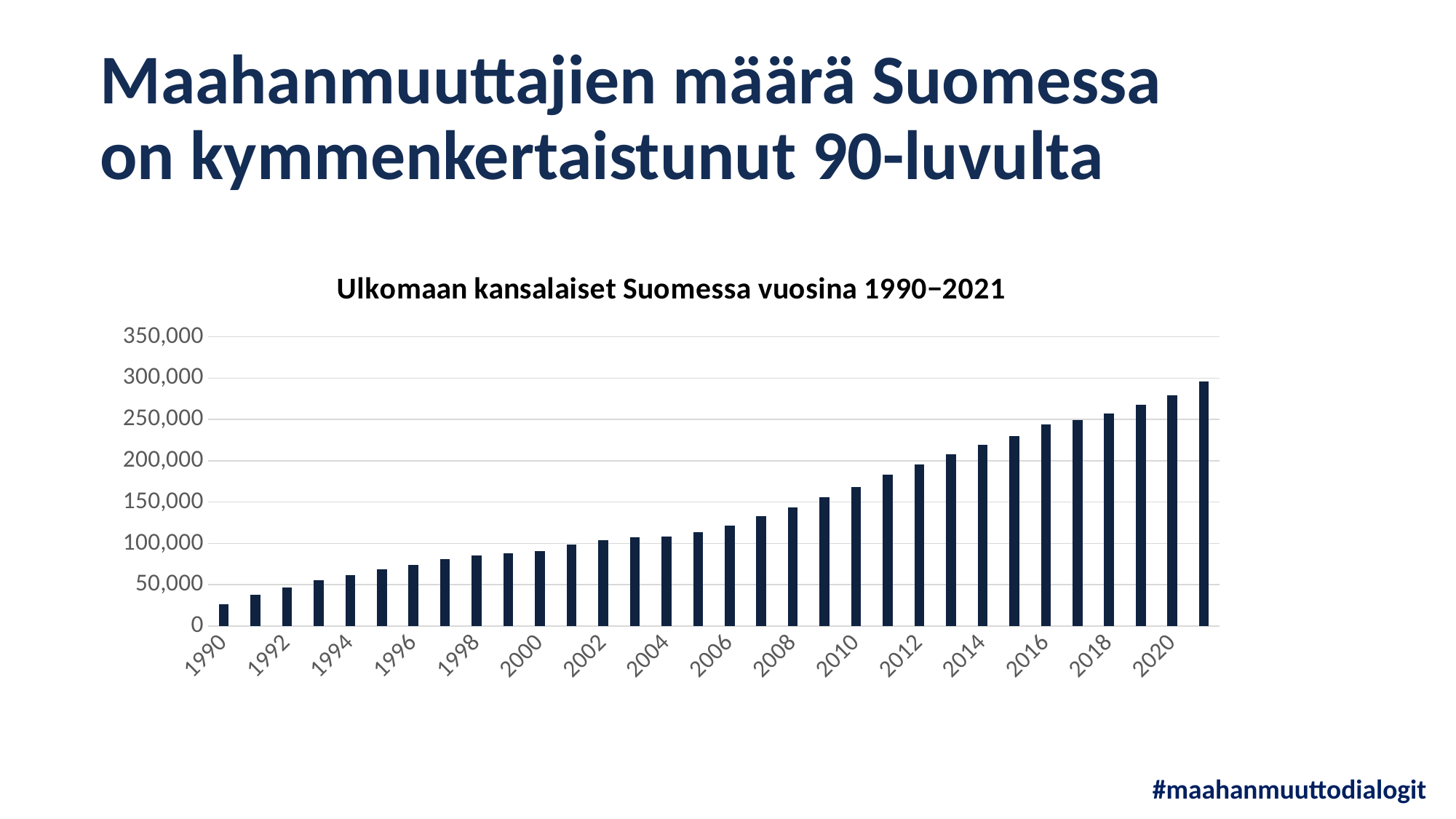
Which year has the highest value in the chart? 2021 Is the value for 2010 greater or less than 150,000? greater Is the value for 2020 greater or less than 250,000? greater How many bars (years) are plotted in the chart? 32 What is the title of the chart? Ulkomaan kansalaiset Suomessa vuosina 1990–2021 Which year has the lowest value in the chart? 1990 Is the value for 1990 greater or less than 50,000? less What kind of chart is shown on the slide? bar chart Do the values rise or fall from 1990 to 2021? rise Which year has the larger value, 2000 or 2010? 2010